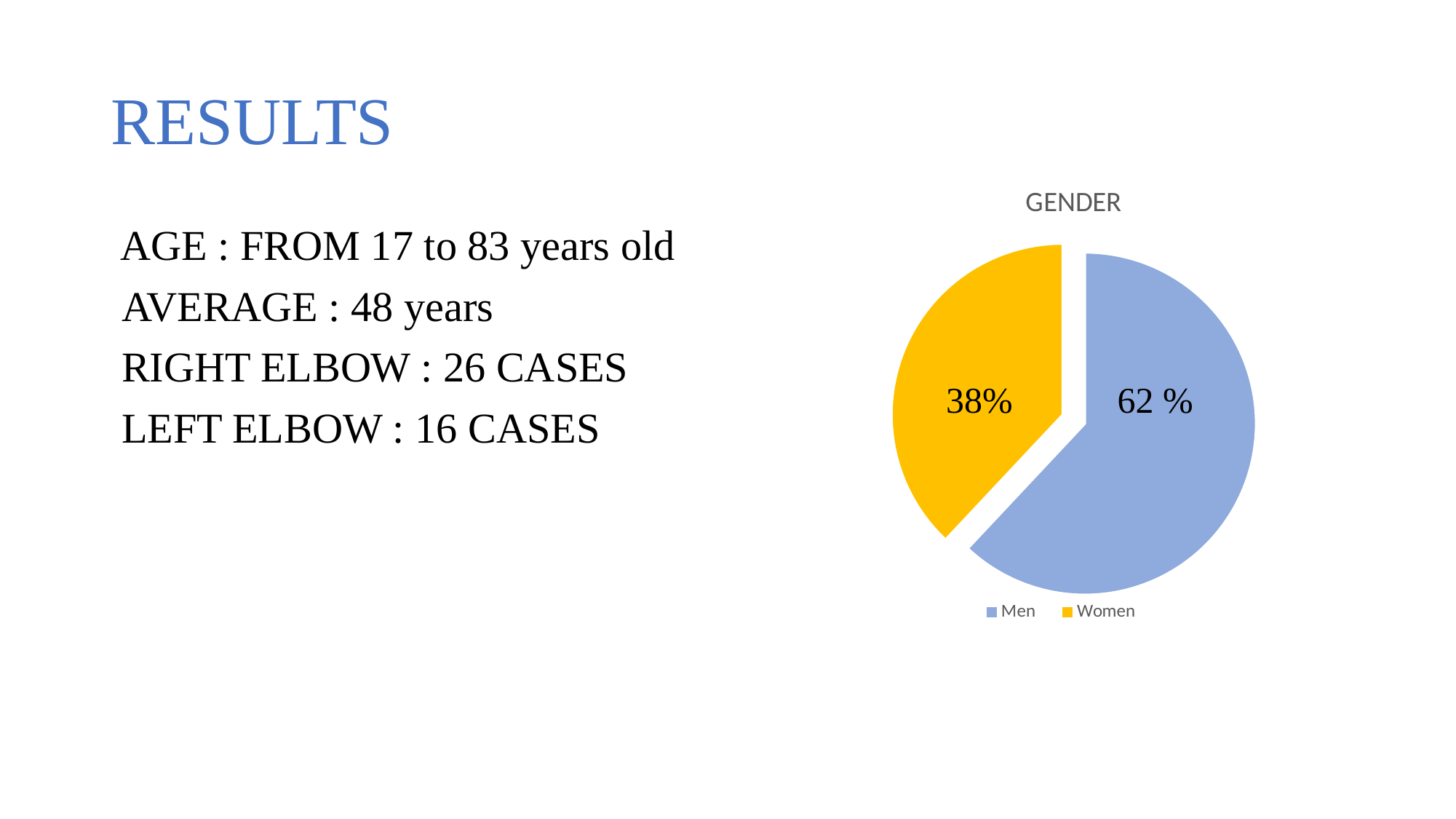
Which category has the smallest slice of the pie? Women What share of the pie is labelled for Women? 38% How many categories does the pie chart show? 2 What type of chart is shown on the slide? pie chart What is the difference in percentage points between the Men and Women slices? 24 What colour is the Women slice? yellow How many entries does the legend list? 2 Which category has the largest slice of the pie? Men What share of the pie is labelled for Men? 62 % Is the share for Men greater or less than 50%? greater Which slice is larger, Men or Women? Men What is the title of the chart? GENDER